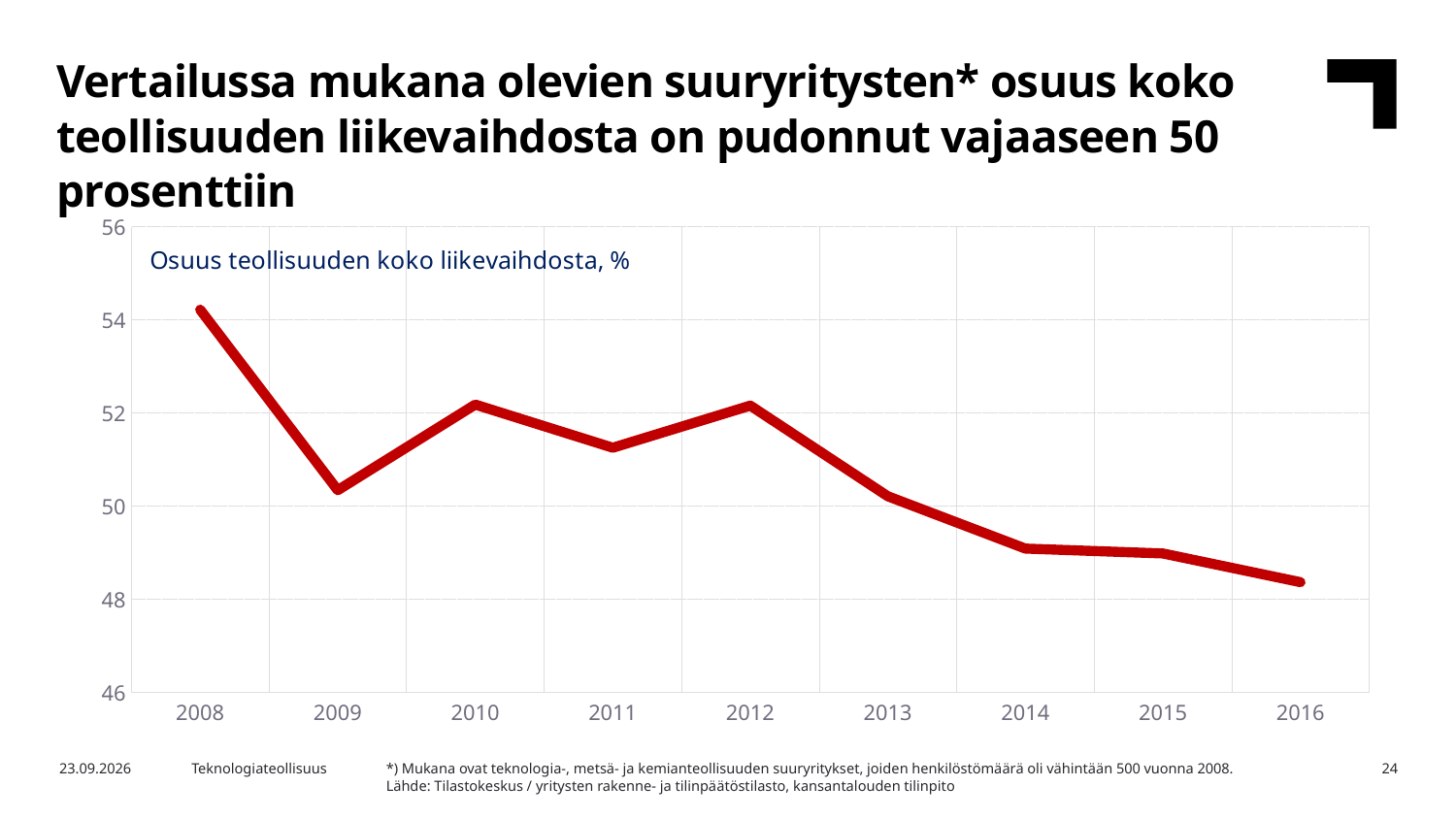
Which year has the larger value, 2008 or 2009? 2008 Which year has the highest value in the chart? 2008 Is the value for 2016 greater or less than 50? less Is the value for 2014 greater or less than 50? less What kind of chart is shown on the slide? line chart What is the label shown inside the chart area describing the plotted series? Osuus teollisuuden koko liikevaihdosta, % Is the value for 2010 greater or less than 52? greater Which year has the larger value, 2012 or 2013? 2012 Which year has the lowest value in the chart? 2016 Overall, do the values rise or fall from 2008 to 2016? fall How many years are plotted on the x axis of the chart? 9